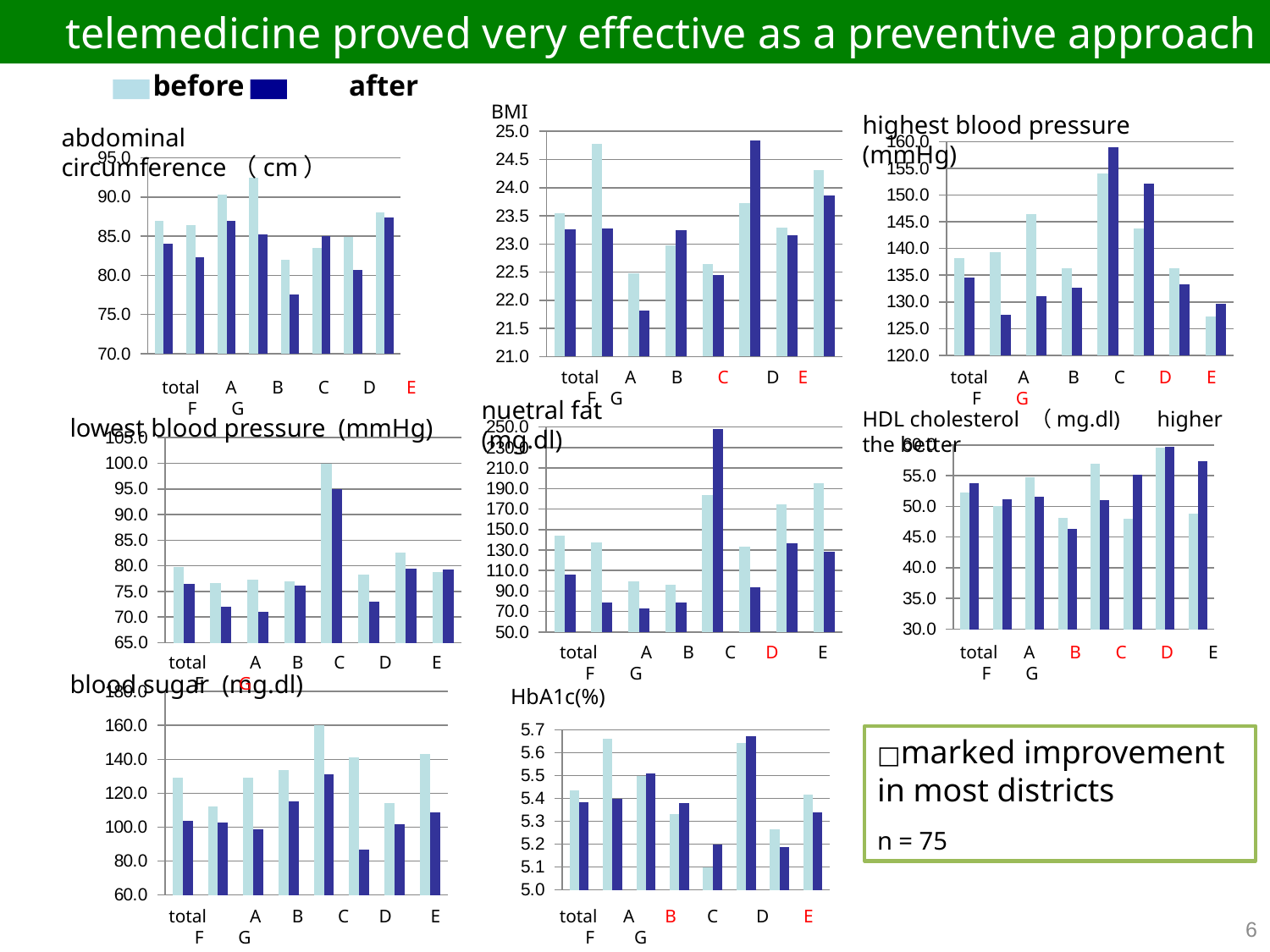
What kind of chart is the 'abdominal circumference (cm)' chart? bar chart In the 'BMI' chart, which category has the lowest 'after' value? A In the 'nuetral fat (mg.dl)' chart, which category has the highest 'after' value? C According to the legend, which colour represents the 'after' series? dark blue In the 'abdominal circumference (cm)' chart, is the 'before' value for total greater or less than 85.0? greater In the 'lowest blood pressure (mmHg)' chart, which category has the highest 'before' value? C In the 'BMI' chart, how many categories are shown on the x axis? 8 In the 'highest blood pressure (mmHg)' chart, is the 'before' value for C greater or less than 150.0? greater How many series does the legend at the top of the slide list? 2 In the 'HbA1c(%)' chart, which is larger: the 'before' value for C or the 'before' value for D? D In the 'HDL cholesterol (mg.dl)' chart, is the 'before' value for D greater or less than 55.0? greater